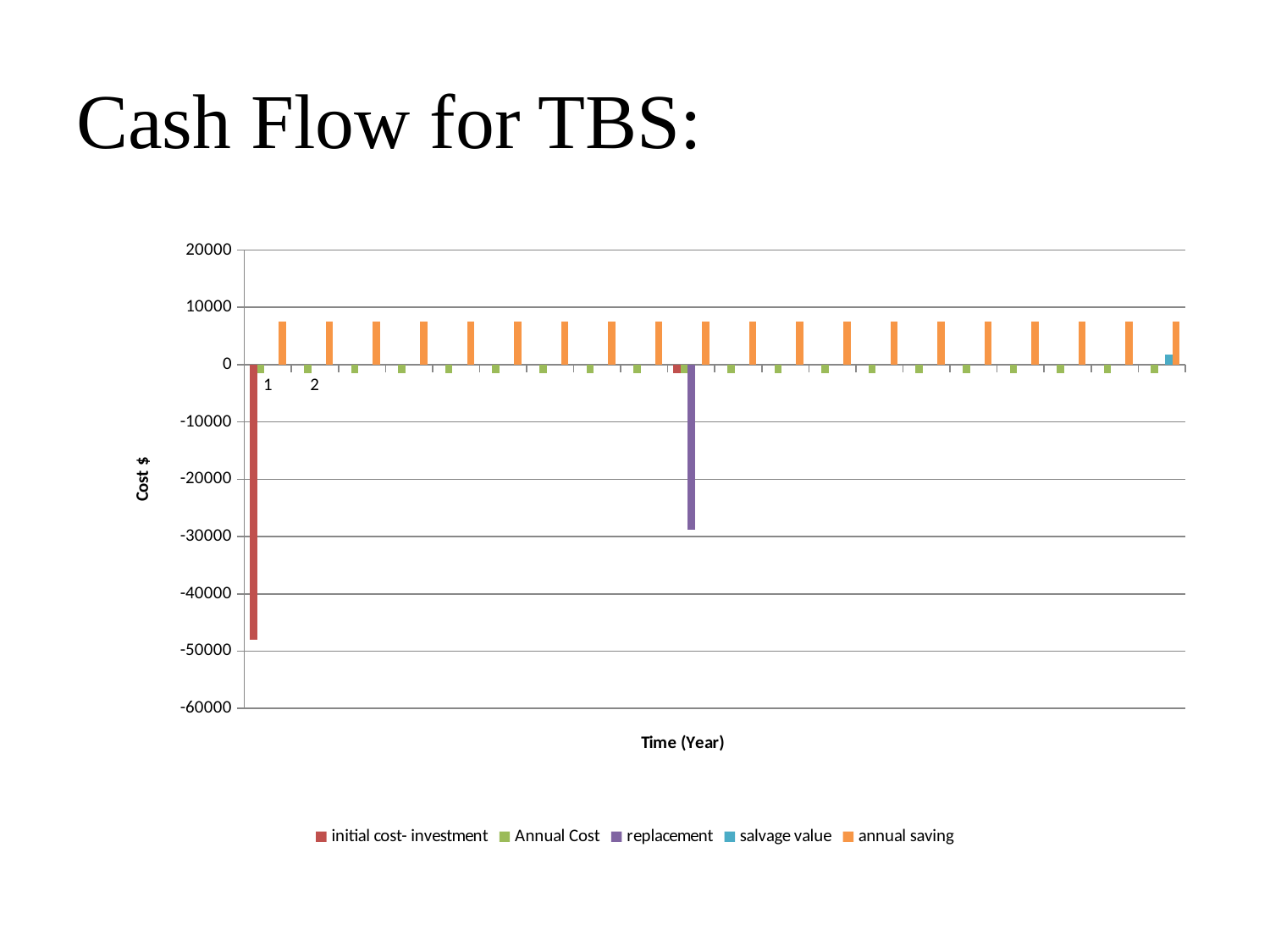
How many series does the legend list? 5 Which series has the highest positive value in the chart? annual saving What is the label on the horizontal axis of the chart? Time (Year) Is the salvage value bar greater or less than 0? greater What is the title of the chart on the slide? Cash Flow for TBS: Which is larger, the annual saving bars or the salvage value bar? annual saving Are the annual saving bars greater or less than 10000? less Is the value of the initial cost- investment bar greater or less than -40000? less Which is more negative, the initial cost- investment bar or the replacement bar? initial cost- investment Which series has the lowest (most negative) value in the chart? initial cost- investment What kind of chart is shown on the slide? bar chart